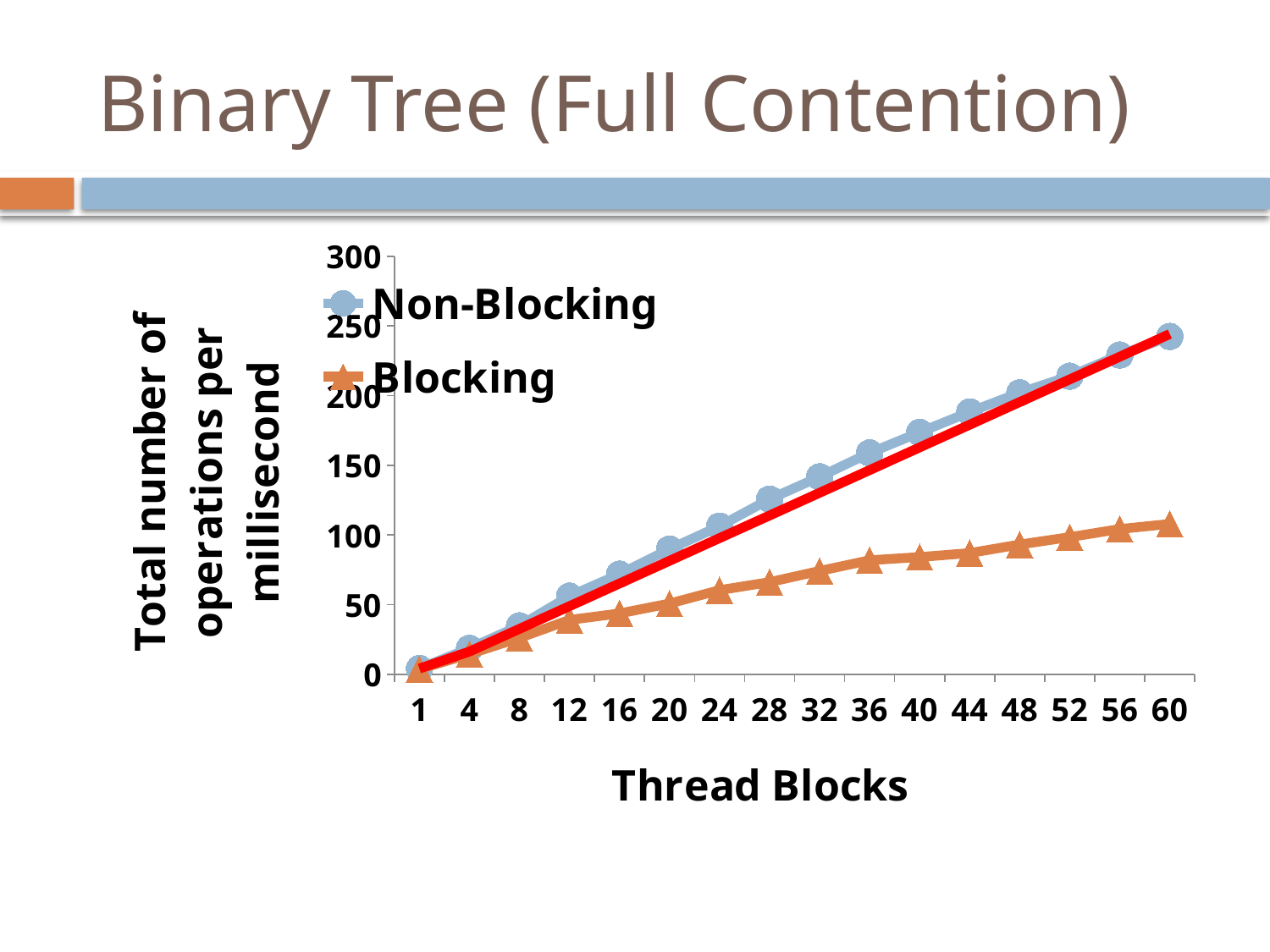
Which series is drawn with triangle markers? Blocking What is the label of the x axis? Thread Blocks What kind of chart is shown on the slide? line chart Is the Blocking value at 60 thread blocks greater or less than 150? less Is the Blocking value at 36 thread blocks greater or less than 100? less How many thread block values are labelled on the x axis? 16 How many series does the legend list? 2 Does the Blocking series rise or fall as the number of thread blocks increases? rise Is the Non-Blocking value at 36 thread blocks greater or less than 100? greater Does the Non-Blocking series rise or fall as the number of thread blocks increases? rise Which series has the higher value at 60 thread blocks, Non-Blocking or Blocking? Non-Blocking